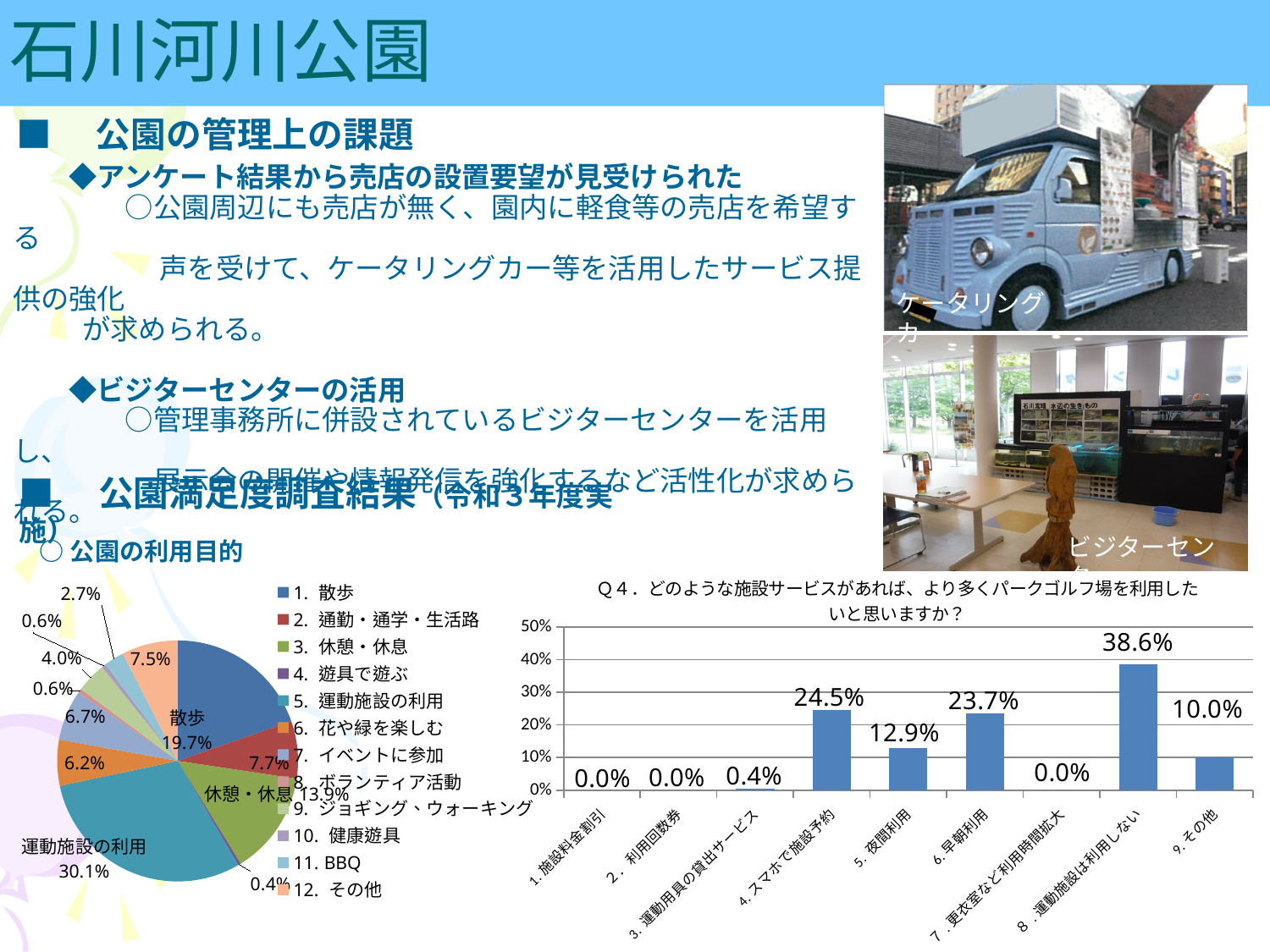
In the bar chart titled Q４, which is larger: the value for 5. 夜間利用 or 9. その他? 5. 夜間利用 In the bar chart titled Q４, what is the value for 8. 運動施設は利用しない? 38.6% In the bar chart titled Q４, which category has the highest value? 8. 運動施設は利用しない In the pie chart 公園の利用目的, what share does 運動施設の利用 have? 30.1% In the bar chart titled Q４, how many categories are shown on the x axis? 9 In the bar chart titled Q４, what is the difference between the values for 4. スマホで施設予約 and 6. 早朝利用? 0.8% What kind of chart is the chart titled Q４ on the right of the slide? bar chart In the pie chart 公園の利用目的, what is the difference between the shares of 運動施設の利用 and 散歩? 10.4% In the pie chart 公園の利用目的, how many entries does the legend list? 12 In the pie chart 公園の利用目的, what share does 散歩 have? 19.7% In the bar chart titled Q４, how many categories have a value of 0.0%? 3 In the bar chart titled Q４, what is the value for 4. スマホで施設予約? 24.5%